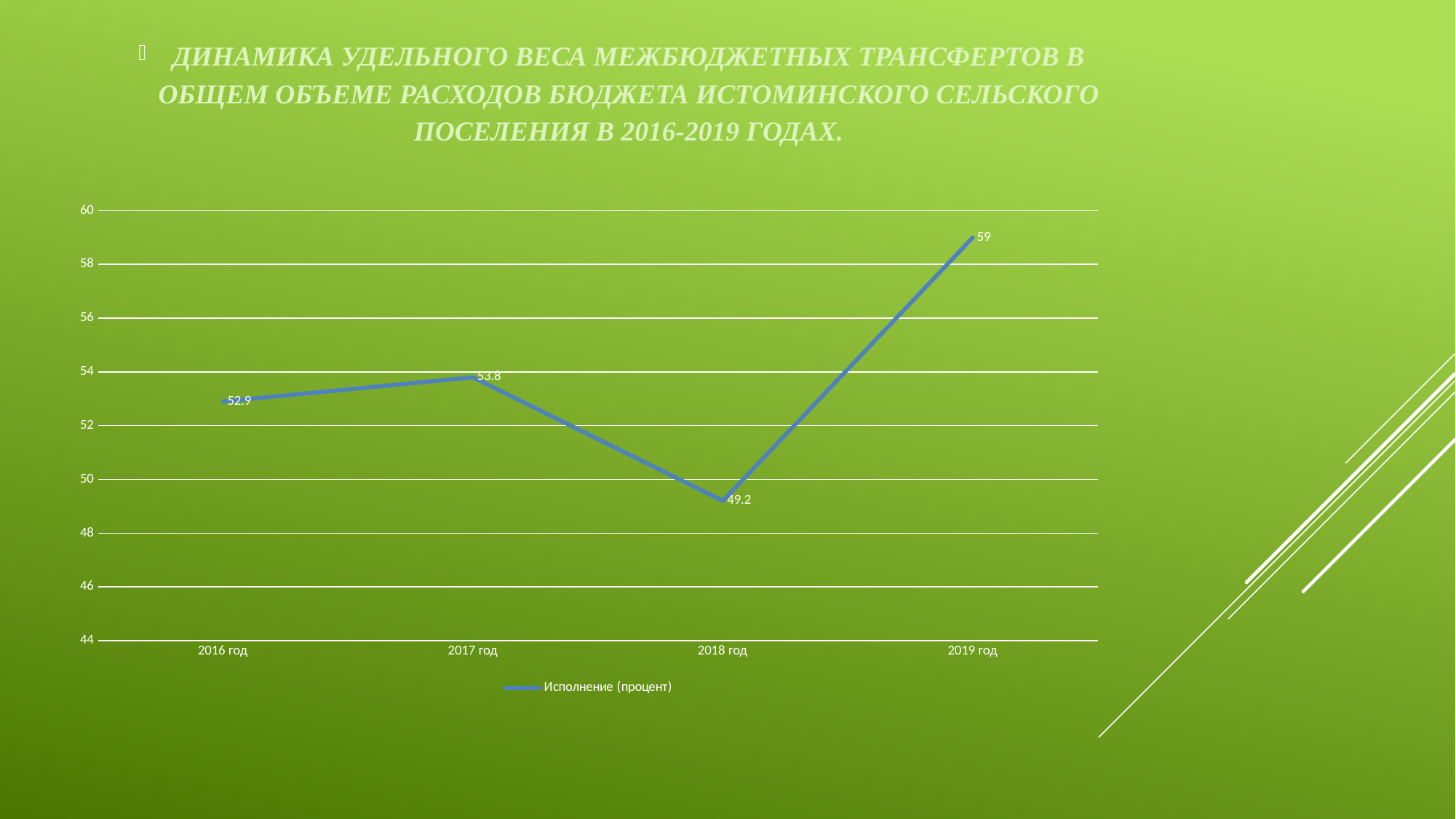
What is the difference between the values for 2019 год and 2018 год? 9.8 Which is larger, the value for 2017 год or the value for 2018 год? 2017 год What is the value for 2018 год? 49.2 What is the value for 2019 год? 59 Which year has the highest value? 2019 год What is the value for 2016 год? 52.9 What is the difference between the values for 2017 год and 2016 год? 0.9 Is the value for 2018 год greater or less than 50? less What kind of chart is shown? line chart Which year has the lowest value? 2018 год What series name does the legend show? Исполнение (процент) How many years are plotted on the x axis? 4